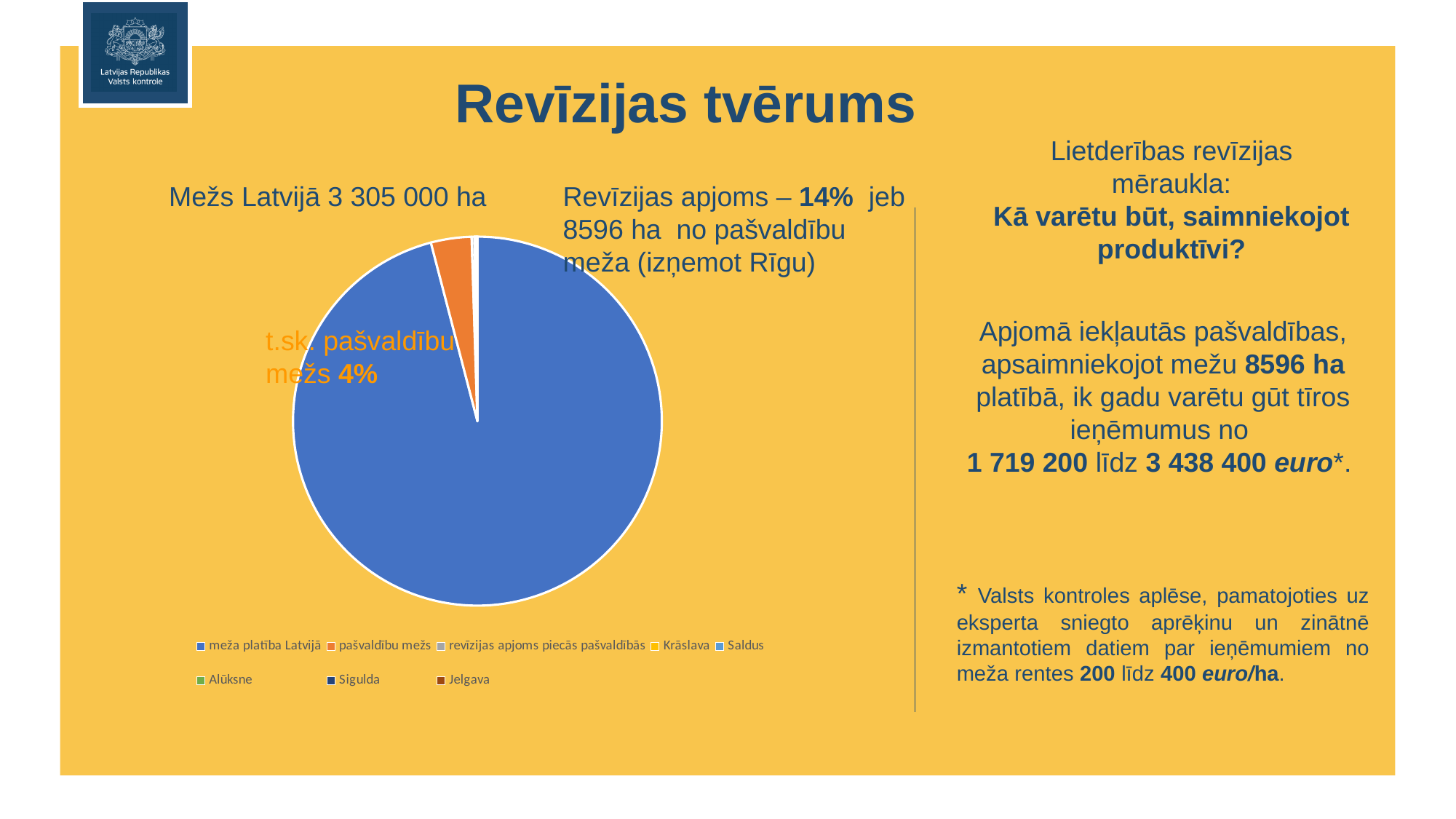
How many entries does the legend of the pie chart list? 8 Which slice is larger in the pie chart: 'meža platība Latvijā' or 'pašvaldību mežs'? meža platība Latvijā What share of the pie does the 'pašvaldību mežs' slice represent, according to the label on the chart? 4% What total forest area in Latvia is stated in the heading above the pie chart? 3 305 000 ha Is the share of the 'meža platība Latvijā' slice greater or less than 50%? greater What colour is the 'pašvaldību mežs' slice in the pie chart? orange What kind of chart is shown on the slide? pie chart Which category has the largest slice in the pie chart? meža platība Latvijā Is the share of the 'pašvaldību mežs' slice greater or less than 10%? less